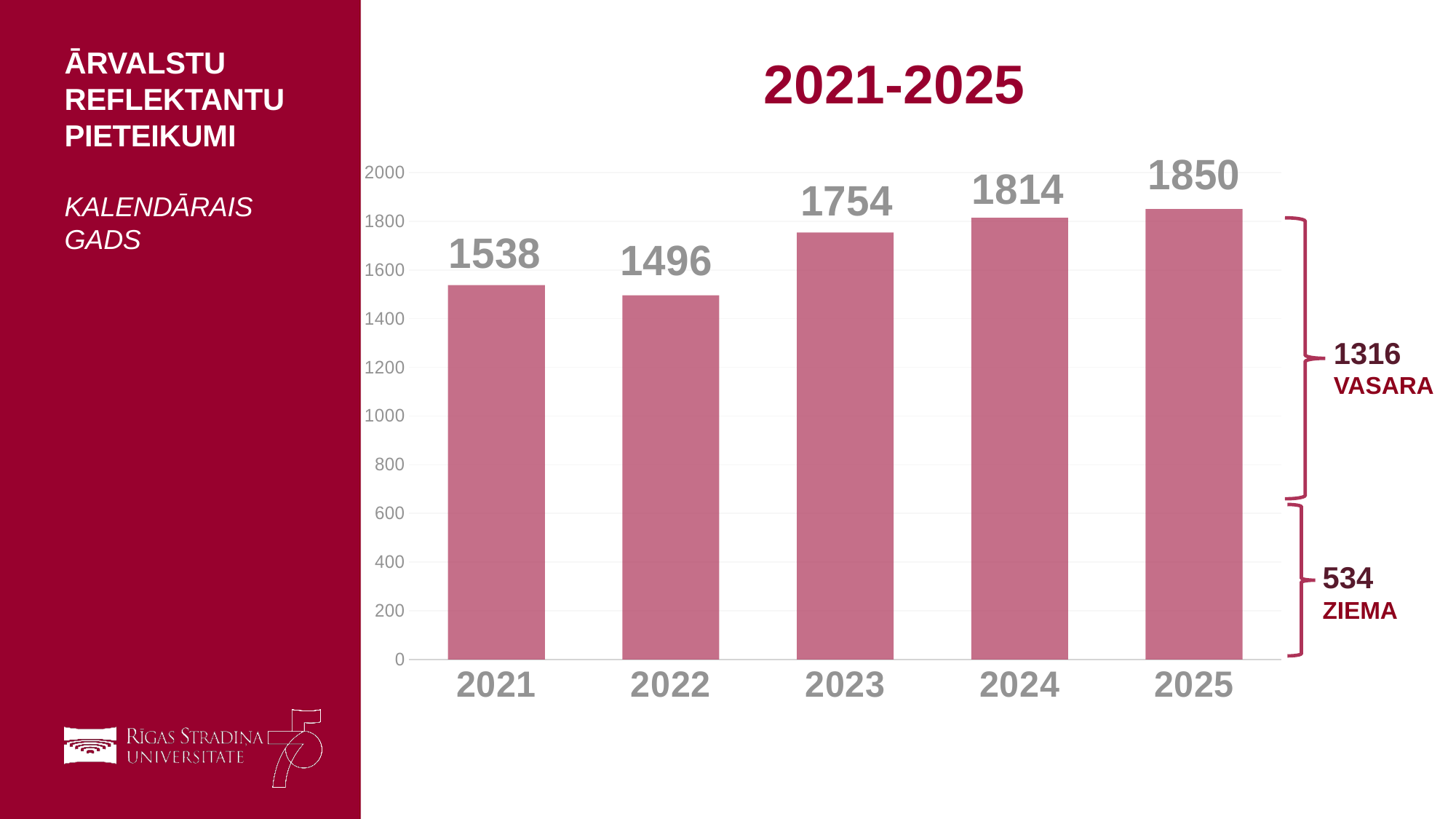
What is the difference between the values for 2025 and 2021? 312 How many years are shown on the chart? 5 What is the value for 2025? 1850 What kind of chart is shown on the slide? bar chart What is the difference between the values for 2024 and 2023? 60 Which year has the lowest value? 2022 What is the value for 2021? 1538 What is the title of the chart? 2021-2025 What is the value for 2023? 1754 Which year has the highest value? 2025 Do the values generally rise or fall from 2022 to 2025? rise Which is larger, the value for 2021 or the value for 2022? 2021